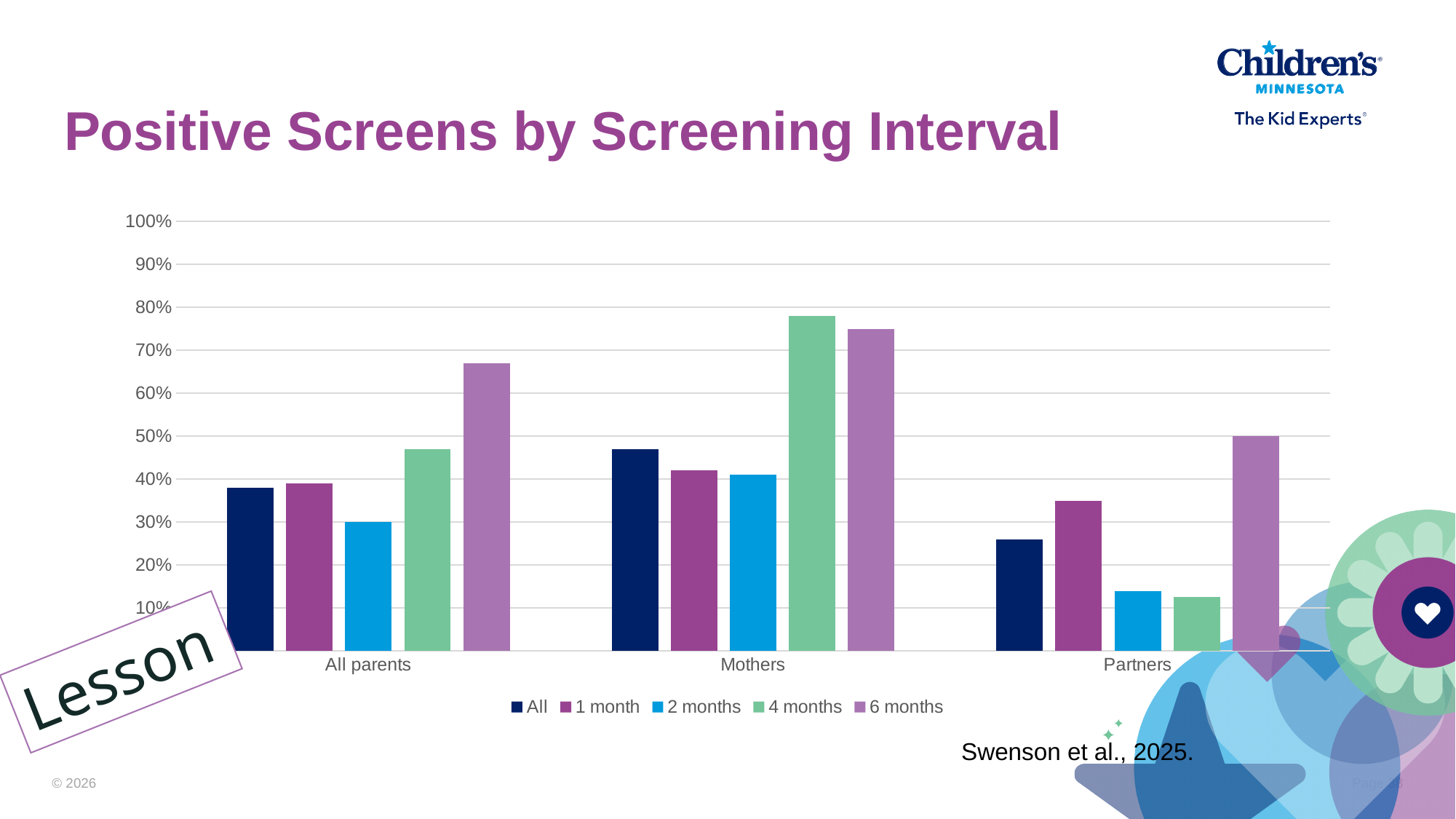
For All parents, which screening interval has the highest bar? 6 months For Partners, which screening interval has the highest bar? 6 months For Mothers, which screening interval has the highest bar? 4 months Which is larger: the 4 months value for Mothers or the 4 months value for All parents? Mothers What kind of chart is shown on the slide? bar chart What is the title of the chart? Positive Screens by Screening Interval How many series does the legend list? 5 How many categories are shown on the x axis? 3 Is the 6 months value for All parents greater or less than 60%? greater Is the 2 months value for Partners greater or less than 20%? less Is the 4 months value for Mothers greater or less than 70%? greater